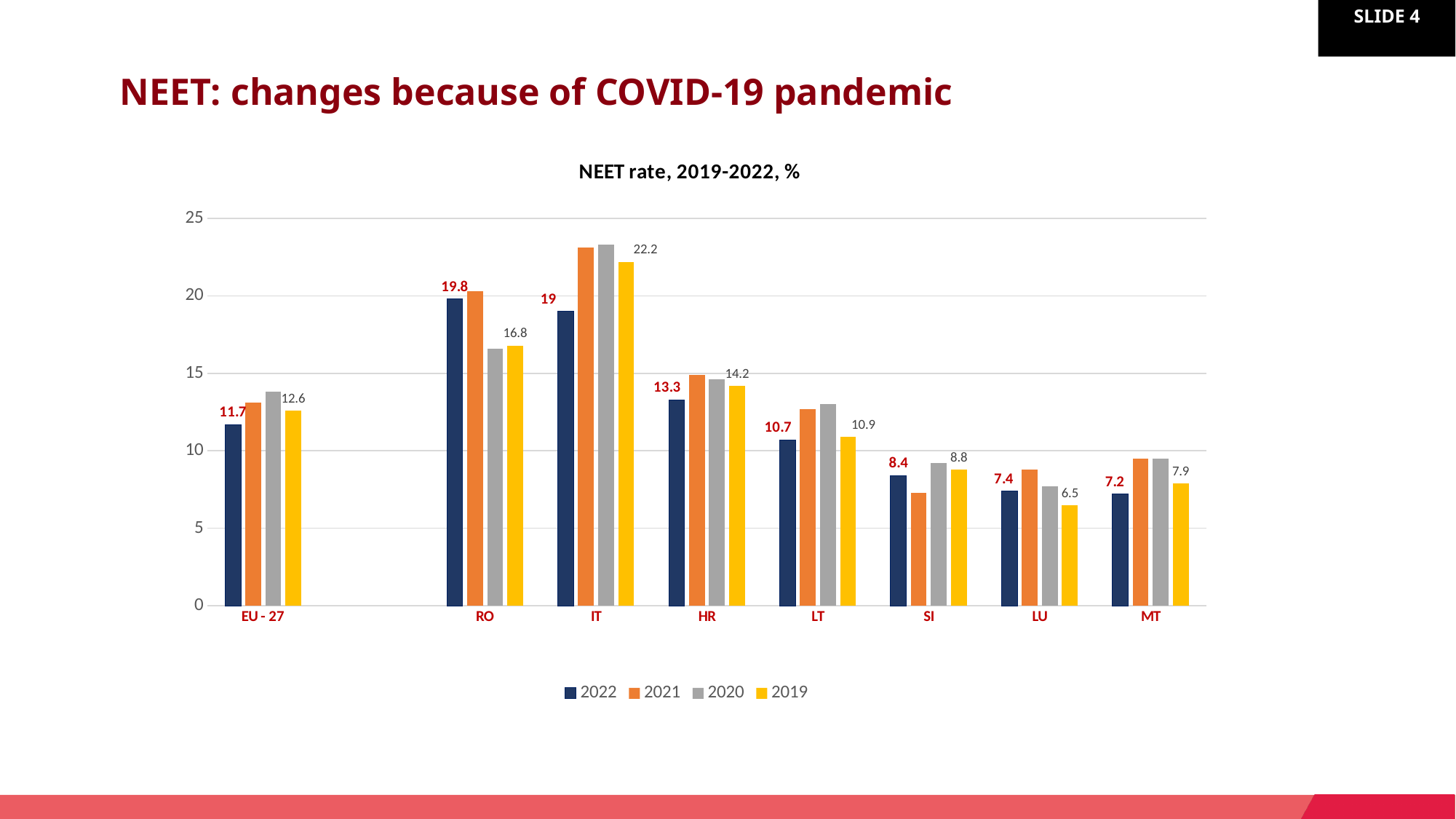
How many categories are shown on the x axis? 8 What is the difference between the 2019 and 2022 NEET rates for IT? 3.2 What is the NEET rate for EU - 27 in 2022? 11.7 Which category has the lowest NEET rate in 2019? LU What kind of chart is shown on the slide? bar chart Is the 2021 NEET rate for IT greater or less than 20? greater Which category has the lowest NEET rate in 2022? MT How many series does the legend list? 4 What is the NEET rate for RO in 2022? 19.8 What is the NEET rate for IT in 2019? 22.2 For RO, which is larger: the 2022 NEET rate or the 2019 NEET rate? 2022 Which country has the highest NEET rate in 2022? RO